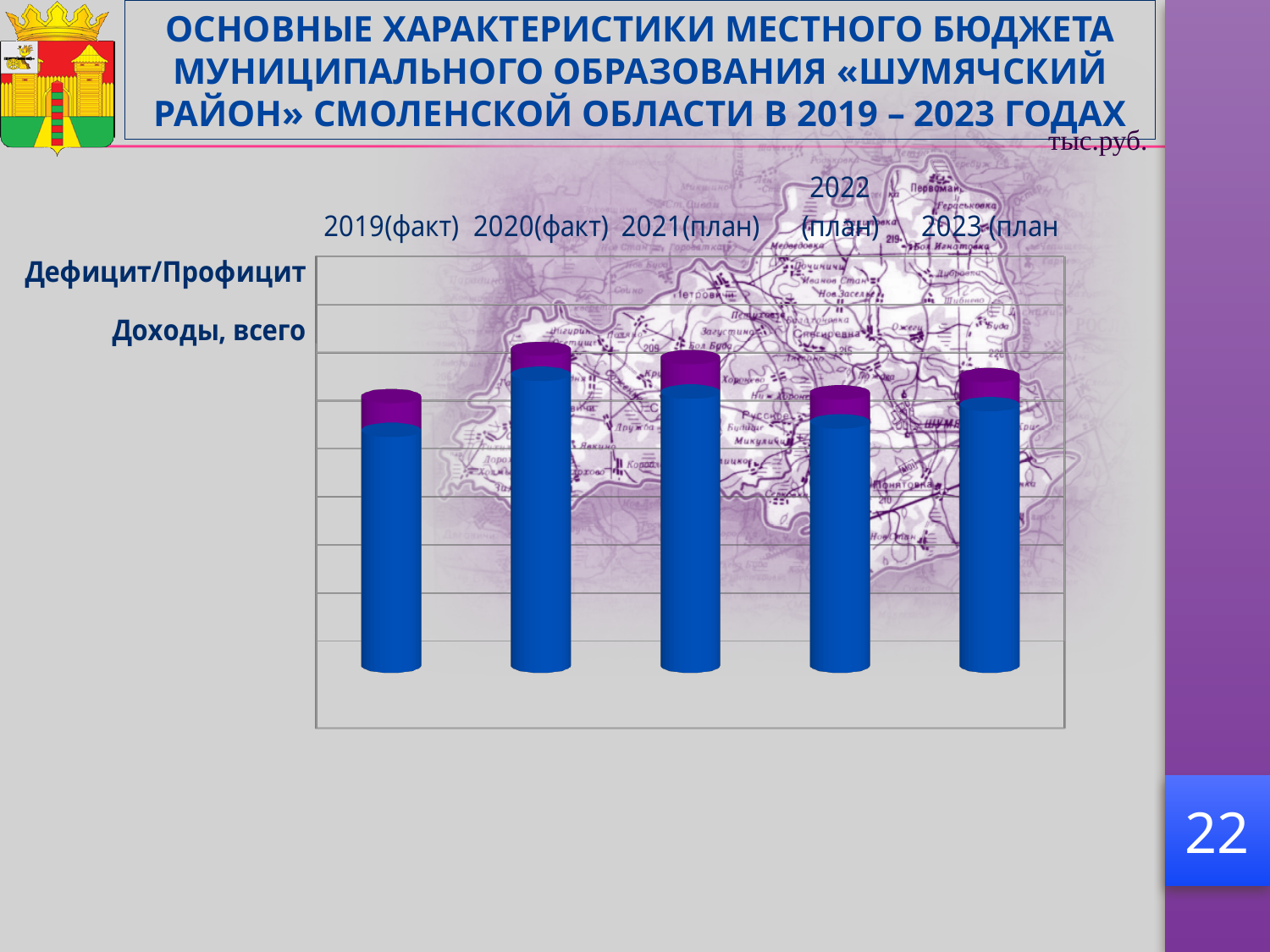
Which category is labelled as actual (факт) rather than planned, besides 2019? 2020(факт) Which bar is taller, 2020(факт) or 2023 (план)? 2020(факт) Which bar is taller, 2021(план) or 2022 (план)? 2021(план) Which bar is taller, 2020(факт) or 2019(факт)? 2020(факт) How many year categories are plotted on the chart? 5 In what unit are the chart values expressed, according to the label at the top right of the chart? тыс.руб. Do the bars rise steadily from 2019(факт) to 2023 (план)? No What kind of chart is shown on the slide? bar chart